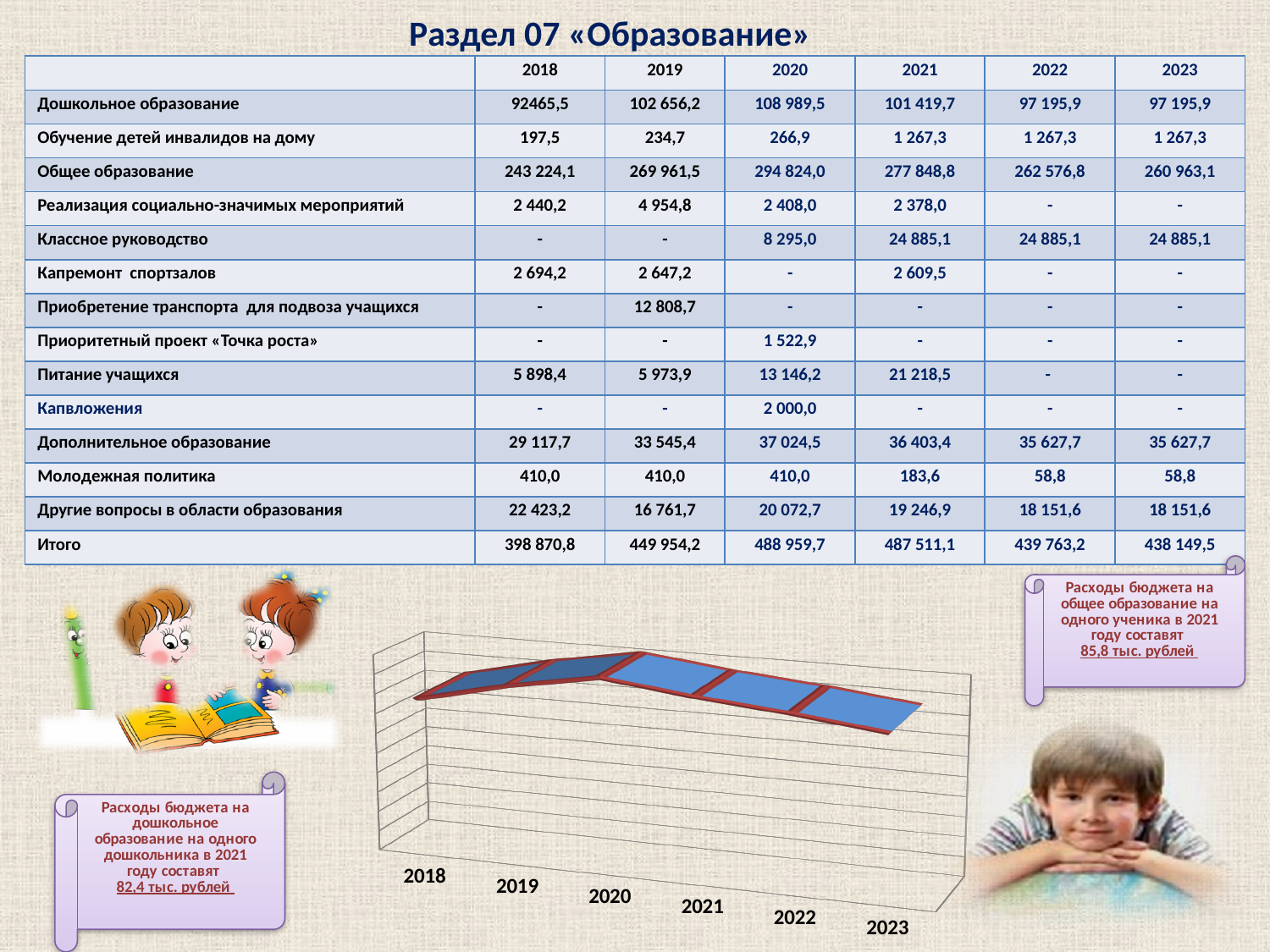
What kind of chart is shown at the bottom of the slide? line chart Does the line in the chart rise or fall from 2021 to 2022? fall How many years are plotted along the x axis of the chart? 6 In the chart, is the value for 2020 higher or lower than the value for 2022? higher In the chart, is the value for 2019 higher or lower than the value for 2018? higher Does the line in the chart rise or fall from 2018 to 2019? rise Which year is the last category on the x axis of the chart? 2023 Which year is the first category on the x axis of the chart? 2018 Does the line in the chart rise or fall between 2022 and 2023? fall